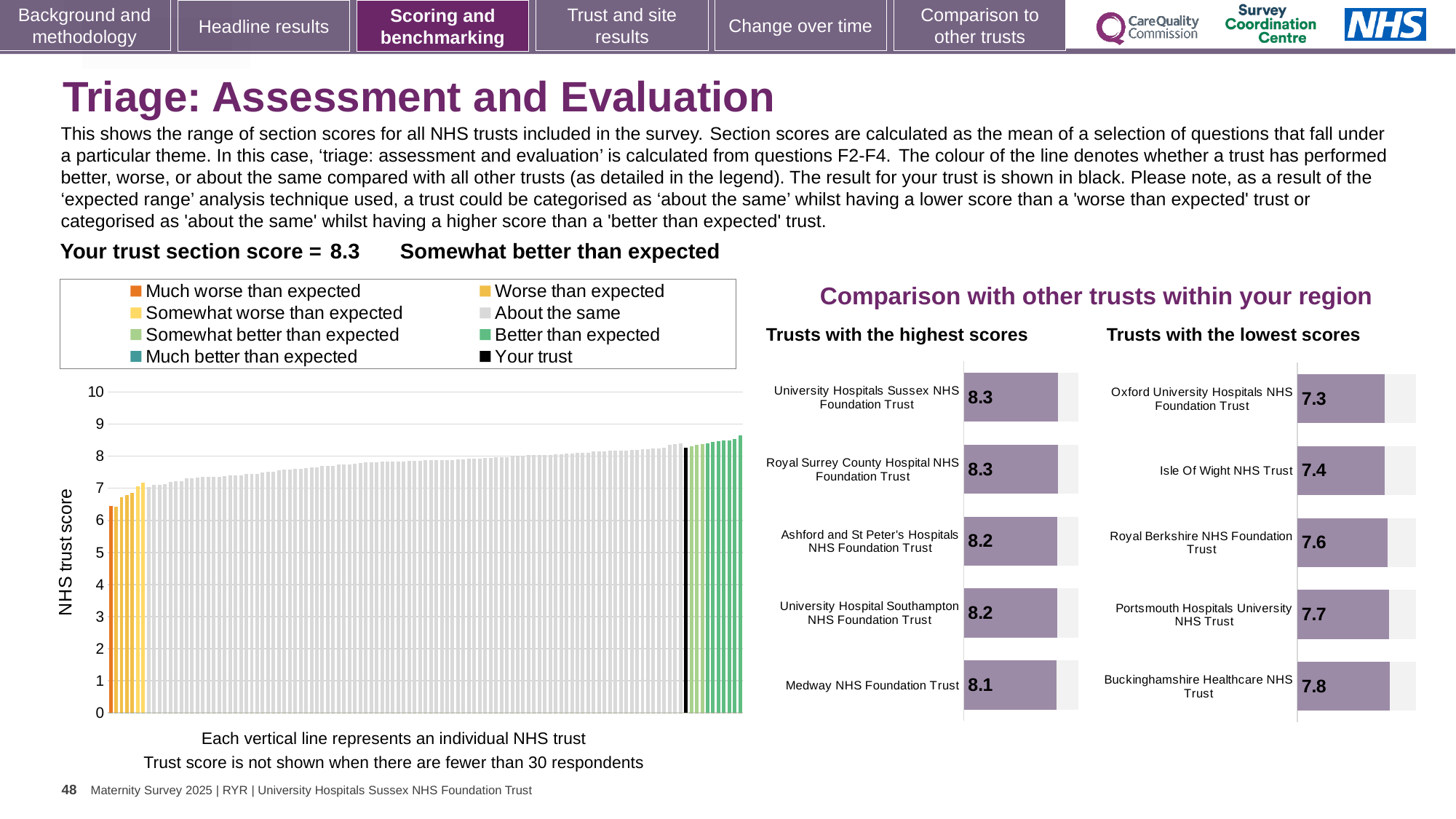
What kind of chart is the 'NHS trust score' chart on the left of the slide? bar chart In the 'Trusts with the lowest scores' chart, what is the difference between the scores of Buckinghamshire Healthcare NHS Trust and Oxford University Hospitals NHS Foundation Trust? 0.5 In the 'Trusts with the lowest scores' chart, which trust has the lowest score? Oxford University Hospitals NHS Foundation Trust How many entries does the legend above the 'NHS trust score' chart list? 8 In the 'Trusts with the lowest scores' chart, what is the score for Portsmouth Hospitals University NHS Trust? 7.7 In the 'NHS trust score' chart on the left, do the bar heights rise or fall from left to right? rise In the 'Trusts with the highest scores' chart, what is the score for Medway NHS Foundation Trust? 8.1 In the 'Trusts with the highest scores' chart, which trust has the lowest score shown? Medway NHS Foundation Trust In the 'Trusts with the lowest scores' chart, what is the score for Oxford University Hospitals NHS Foundation Trust? 7.3 In the 'Trusts with the lowest scores' chart, which has the higher score: Royal Berkshire NHS Foundation Trust or Isle Of Wight NHS Trust? Royal Berkshire NHS Foundation Trust How many trusts are listed in the 'Trusts with the highest scores' chart? 5 In the 'NHS trust score' chart on the left, is the value of the leftmost bar greater or less than 7? less